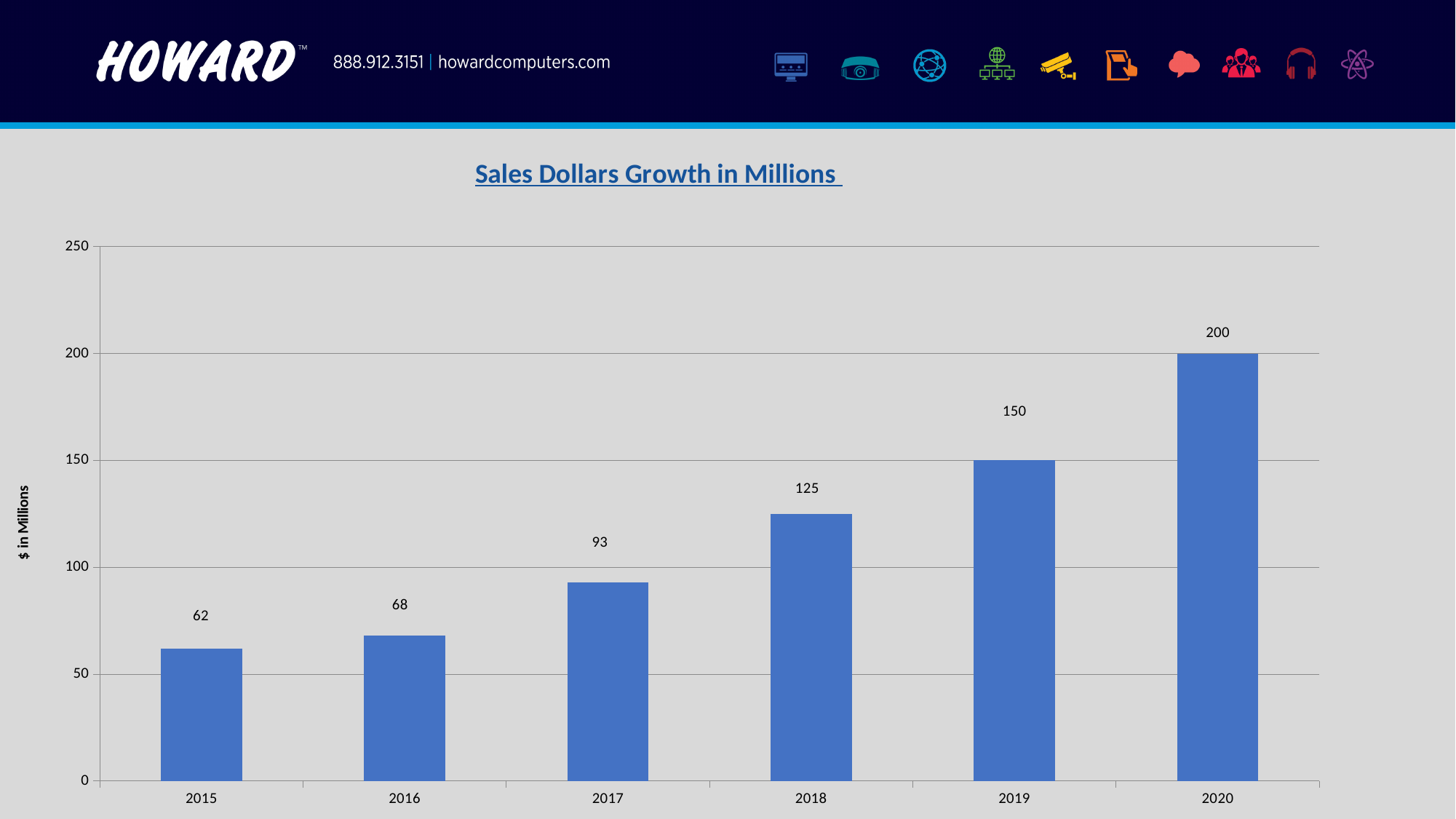
How many years are shown on the x axis? 6 What is the value for 2015? 62 Is the value for 2019 greater or less than 100? greater Which year has the lowest value? 2015 What is the difference between the values for 2020 and 2019? 50 What is the value for 2020? 200 What kind of chart is shown? bar chart Which year has the highest value? 2020 Which is larger, the value for 2018 or the value for 2017? 2018 Do the values rise or fall from 2015 to 2020? rise What is the value for 2018? 125 What is the difference between the values for 2017 and 2016? 25